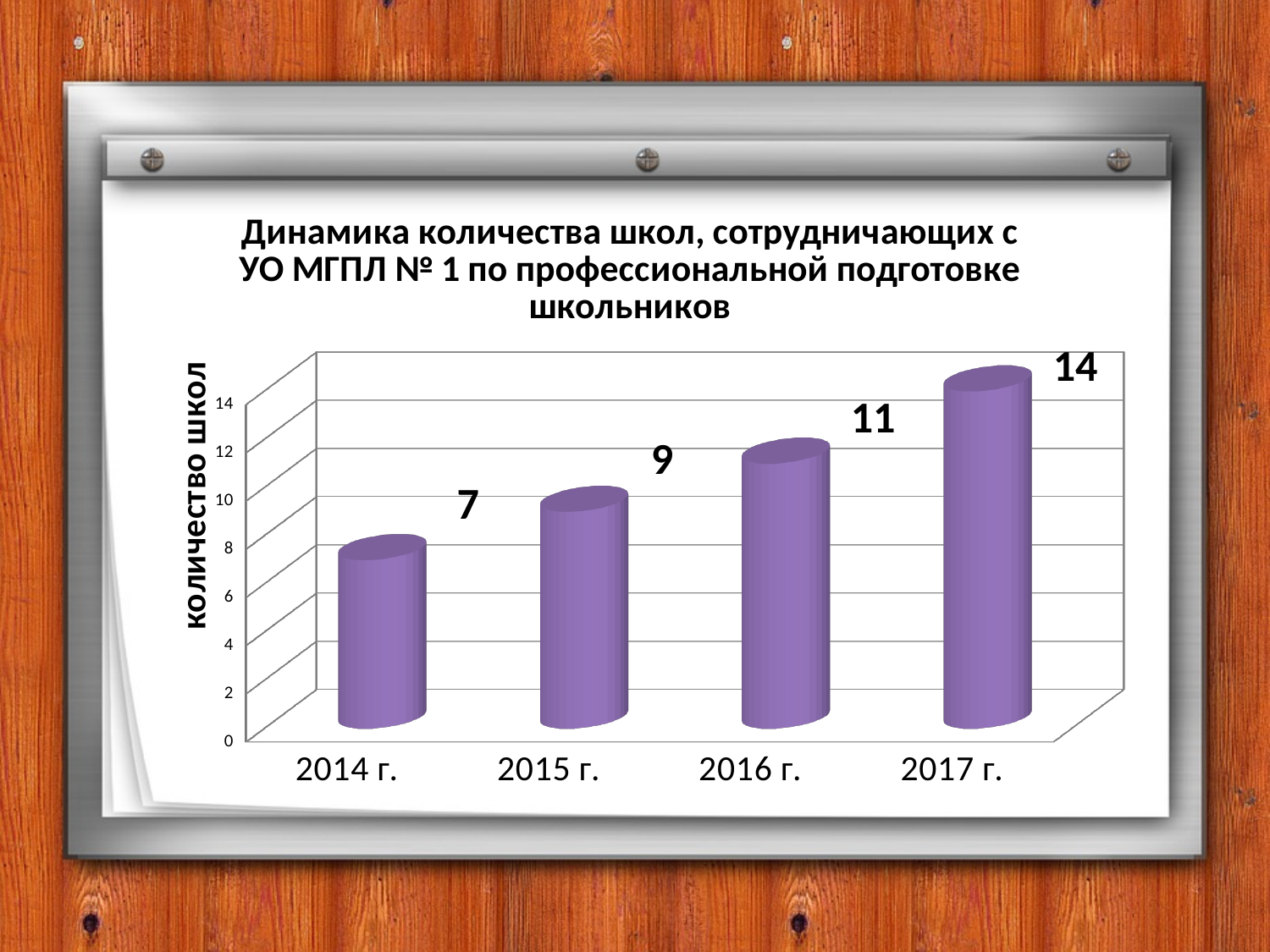
Which year has the highest value? 2017 г. How many years are shown on the x axis? 4 What is the value for 2014 г.? 7 What is the value for 2015 г.? 9 Do the values rise or fall from 2014 г. to 2017 г.? rise What is the difference between the values for 2016 г. and 2015 г.? 2 Which is larger, the value for 2015 г. or the value for 2016 г.? 2016 г. What is the value for 2016 г.? 11 What kind of chart is this? bar chart What is the value for 2017 г.? 14 What is the difference between the values for 2017 г. and 2014 г.? 7 Which year has the lowest value? 2014 г.